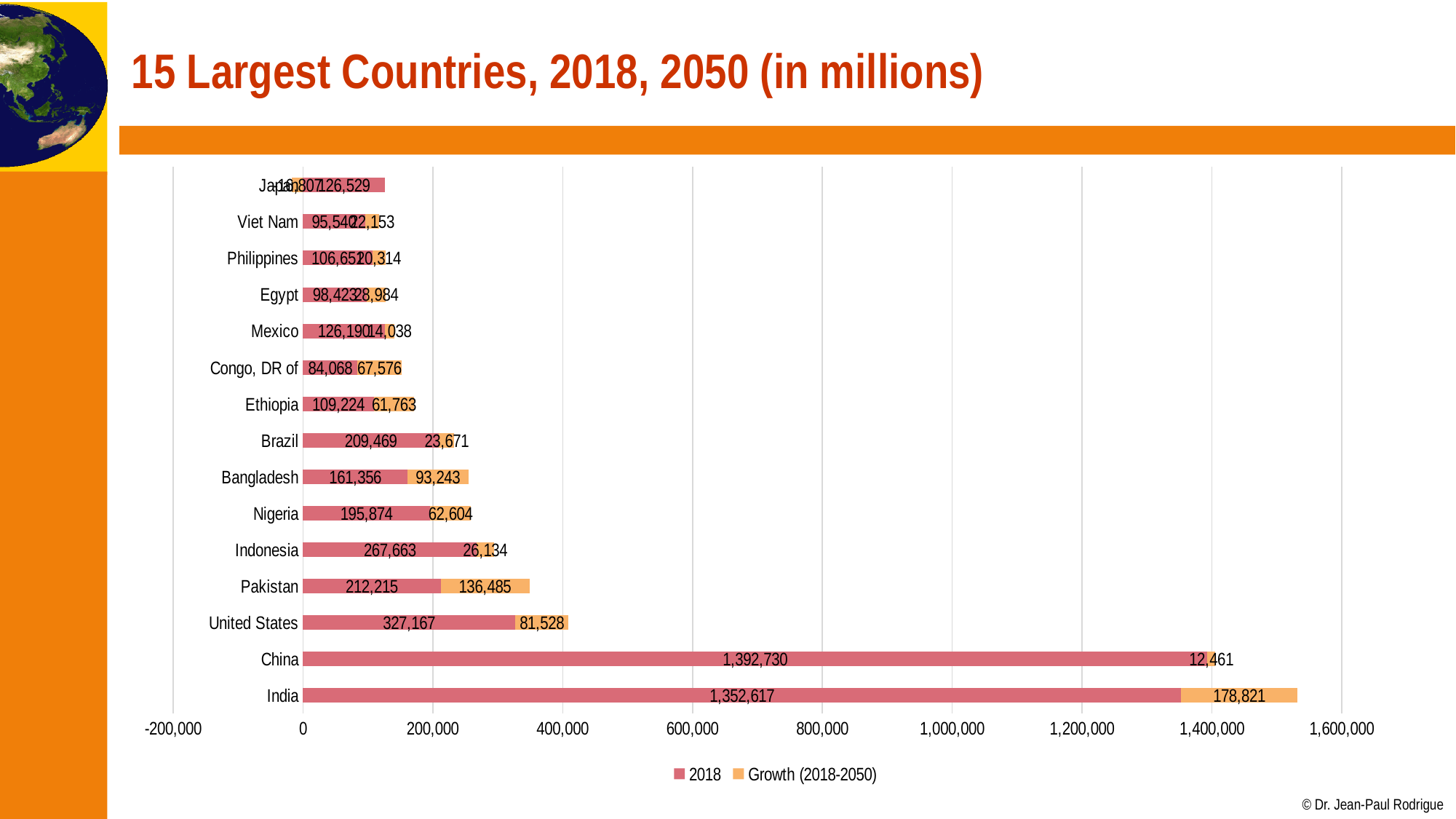
What is the Growth (2018-2050) value for Bangladesh? 93,243 Which country has the largest Growth (2018-2050) value? India What is the Growth (2018-2050) value for Pakistan? 136,485 Which has the larger Growth (2018-2050) value, Pakistan or the United States? Pakistan What is the difference between the 2018 values of China and India? 40,113 What is the 2018 value for India? 1,352,617 What kind of chart is shown on the slide? Stacked bar chart How many countries are shown in the chart? 15 What is the total of the stacked bar for the United States (2018 plus Growth)? 408,695 Which country has the highest 2018 value? China What is the total of the stacked bar for India (2018 plus Growth)? 1,531,438 How many series does the legend list? 2